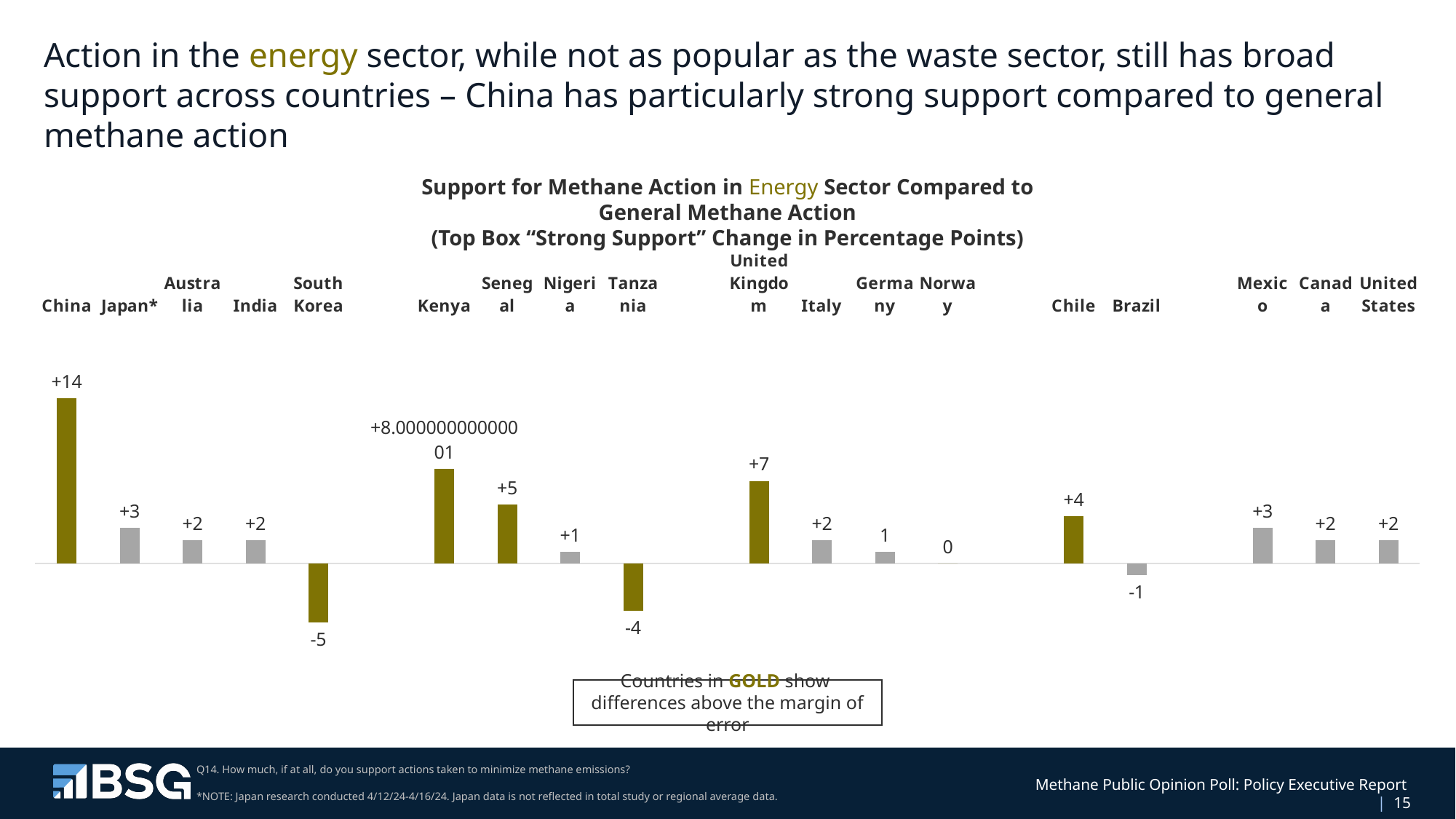
What is the value shown for the United Kingdom? +7 What is the value shown for Tanzania? -4 Which has a larger value, Senegal or Chile? Senegal What is the difference between the values for China and the United Kingdom? 7 Which country has the lowest value? South Korea What kind of chart is shown on the slide? Bar chart What is the value shown for South Korea? -5 According to the note on the chart, what do countries shown in gold indicate? Differences above the margin of error Which country has the highest value? China What is the value shown for Norway? 0 How many countries are shown in the chart? 18 What is the value shown for China? +14